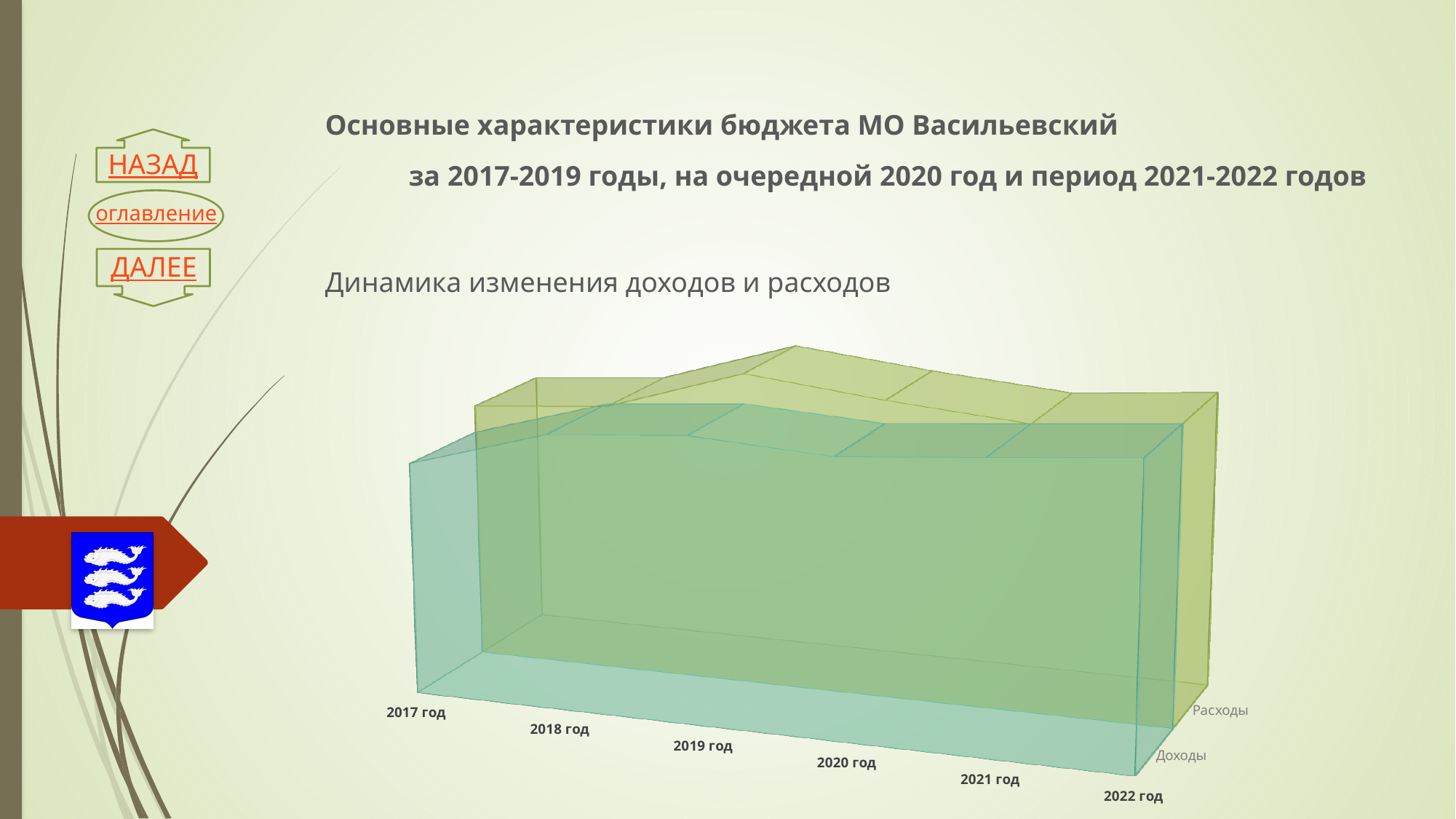
What are the names of the two series in the chart? Расходы and Доходы Does the Доходы series rise or fall from 2017 год to 2018 год? rise How many years (categories) are shown along the x axis of the chart? 6 How many series does the chart show? 2 What is the last year shown on the x axis of the chart? 2022 год In which year does the Расходы series reach its highest point? 2019 год What kind of chart is shown on the slide? area chart What is the title of the chart? Динамика изменения доходов и расходов Does the Расходы series rise or fall from 2019 год to 2020 год? fall What is the first year shown on the x axis of the chart? 2017 год Does the Расходы series rise or fall from 2017 год to 2019 год? rise